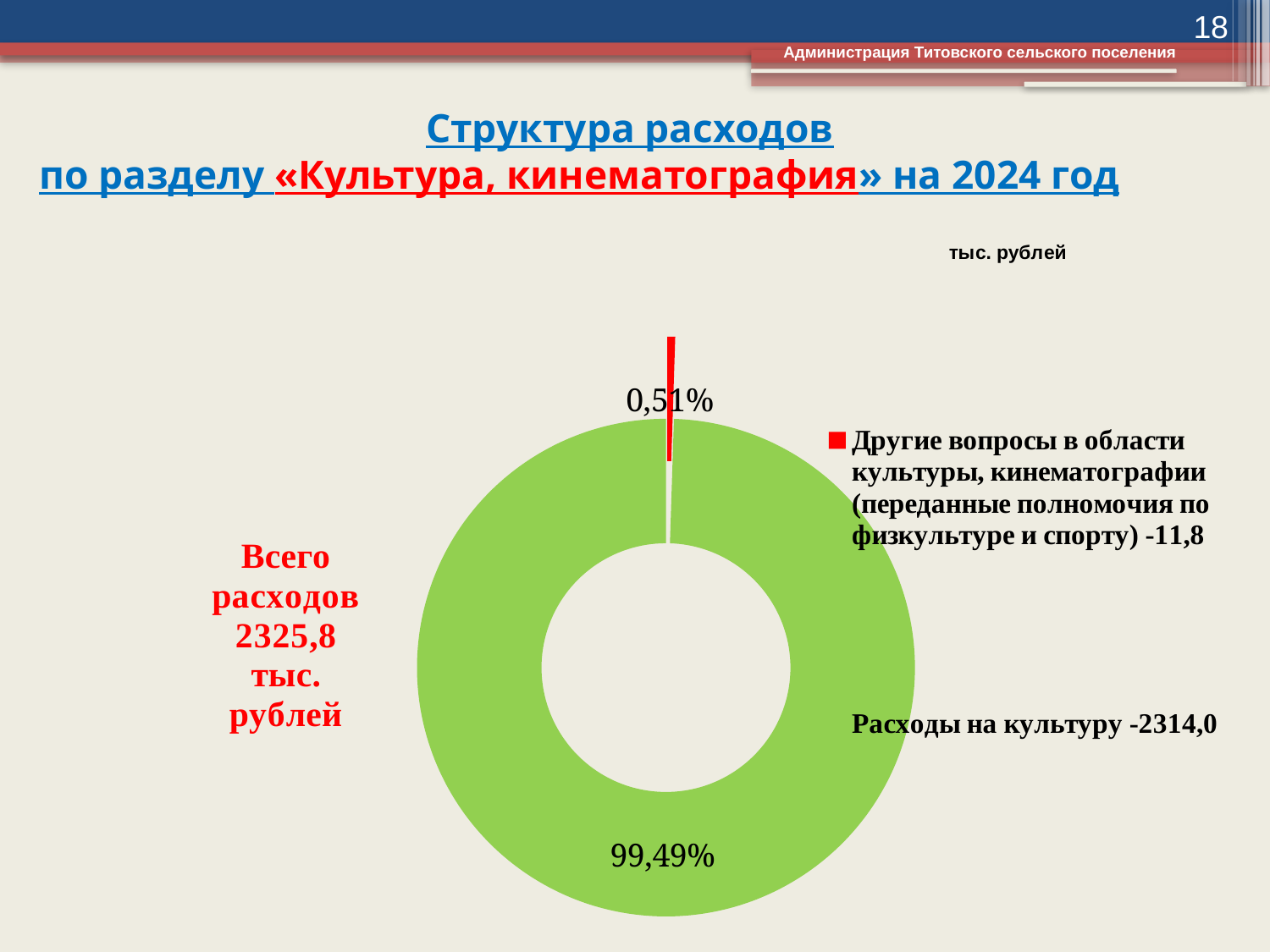
What share of the chart is taken by "Расходы на культуру"? 99,49% How many entries does the legend list? 2 What is the value for "Расходы на культуру" in the legend? 2314,0 What share of the chart is taken by "Другие вопросы в области культуры, кинематографии (переданные полномочия по физкультуре и спорту)"? 0,51% What total expenditure is stated on the slide? 2325,8 тыс. рублей Which category has the smallest share of the chart? Другие вопросы в области культуры, кинематографии (переданные полномочия по физкультуре и спорту) What is the difference between the values for "Расходы на культуру" and "Другие вопросы в области культуры, кинематографии"? 2302,2 What colour is the slice for "Расходы на культуру"? Green How many slices does the chart have? 2 What is the value for "Другие вопросы в области культуры, кинематографии (переданные полномочия по физкультуре и спорту)" in the legend? 11,8 What kind of chart is shown on the slide? Doughnut (pie) chart Which category has the largest share of the chart? Расходы на культуру